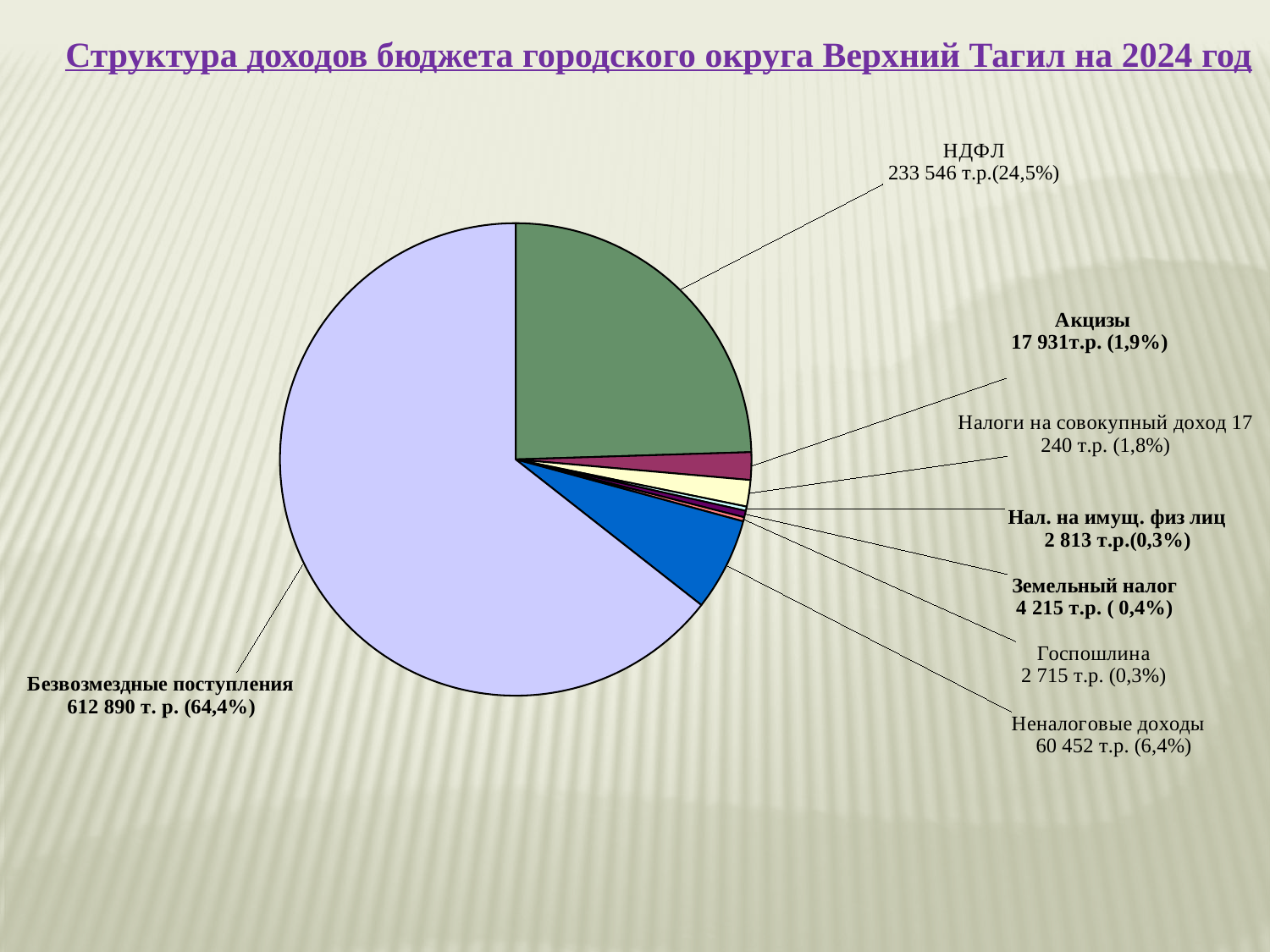
What is the difference between the values for НДФЛ and Неналоговые доходы? 173 094 т.р. How many slices does the pie chart have? 8 Which category has the largest slice of the pie? Безвозмездные поступления What kind of chart is shown on the slide? pie chart What is the title of the chart on the slide? Структура доходов бюджета городского округа Верхний Тагил на 2024 год What is the value shown for Неналоговые доходы? 60 452 т.р. Which category has the smallest value in the pie chart? Госпошлина Which is larger, Акцизы or Налоги на совокупный доход? Акцизы What share of the pie does Земельный налог represent? 0,4% What is the value shown for Акцизы? 17 931т.р. What is the value shown for НДФЛ? 233 546 т.р. What share of the pie does Безвозмездные поступления represent? 64,4%